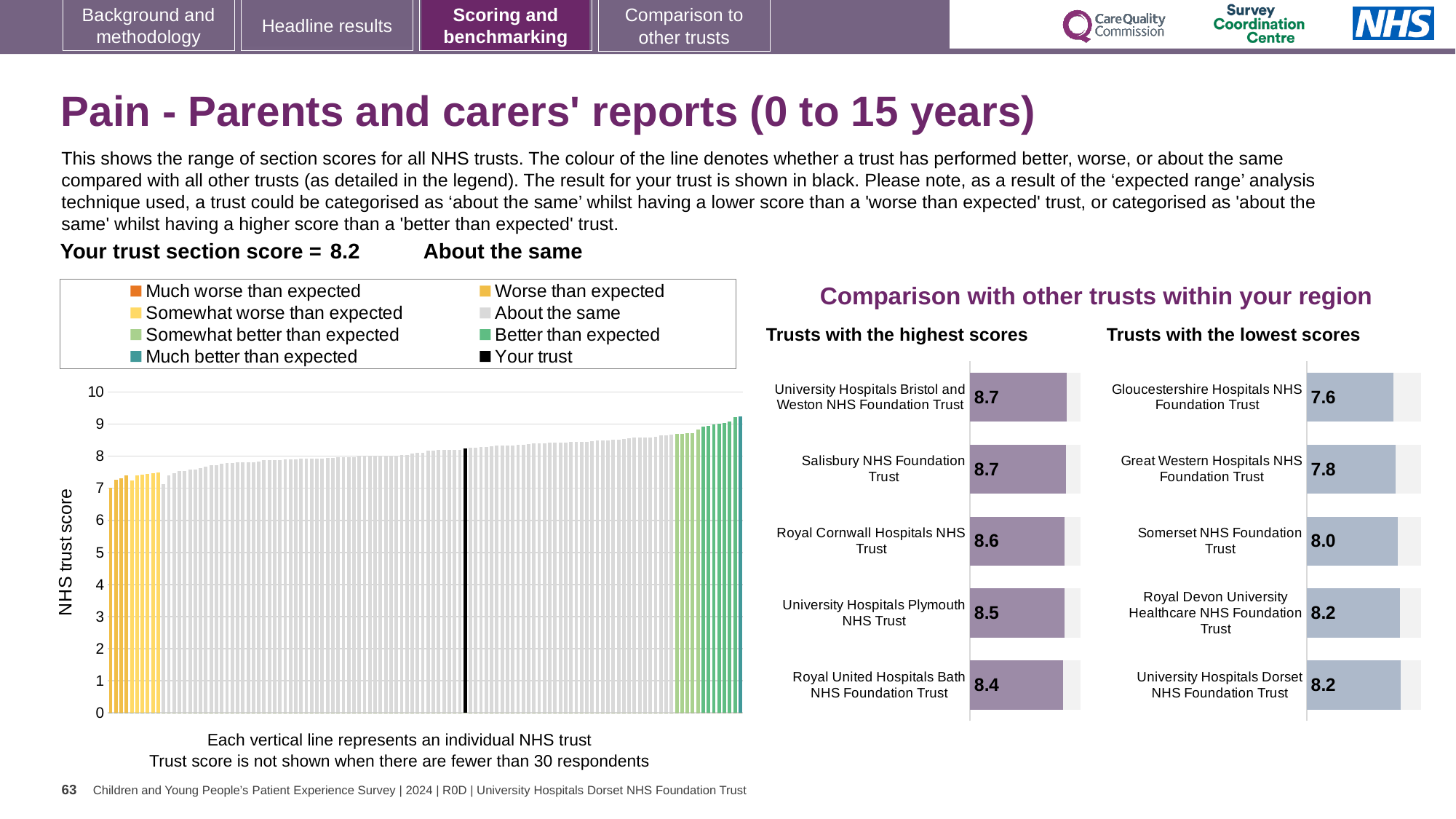
In the 'Trusts with the highest scores' chart, which trust has the lowest score? Royal United Hospitals Bath NHS Foundation Trust In the 'Trusts with the lowest scores' chart, what is the difference between the score for University Hospitals Dorset NHS Foundation Trust and the score for Gloucestershire Hospitals NHS Foundation Trust? 0.6 In the large chart on the left showing the range of section scores, is the value of the lowest bar greater or less than 8? less In the 'Trusts with the highest scores' chart, what is the score for Royal Cornwall Hospitals NHS Trust? 8.6 In the 'Trusts with the lowest scores' chart, what is the score for Great Western Hospitals NHS Foundation Trust? 7.8 How many entries does the legend above the large chart on the left list? 8 What kind of chart is the large chart on the left showing the range of section scores for all NHS trusts? Bar chart In the 'Trusts with the highest scores' chart, what is the difference between the score for Salisbury NHS Foundation Trust and the score for Royal United Hospitals Bath NHS Foundation Trust? 0.3 What is the label on the vertical axis of the large chart on the left? NHS trust score In the 'Trusts with the lowest scores' chart, which trust has the lowest score? Gloucestershire Hospitals NHS Foundation Trust In the 'Trusts with the lowest scores' chart, which has the higher score: Great Western Hospitals NHS Foundation Trust or Somerset NHS Foundation Trust? Somerset NHS Foundation Trust In the 'Trusts with the highest scores' chart, how many trusts are shown? 5